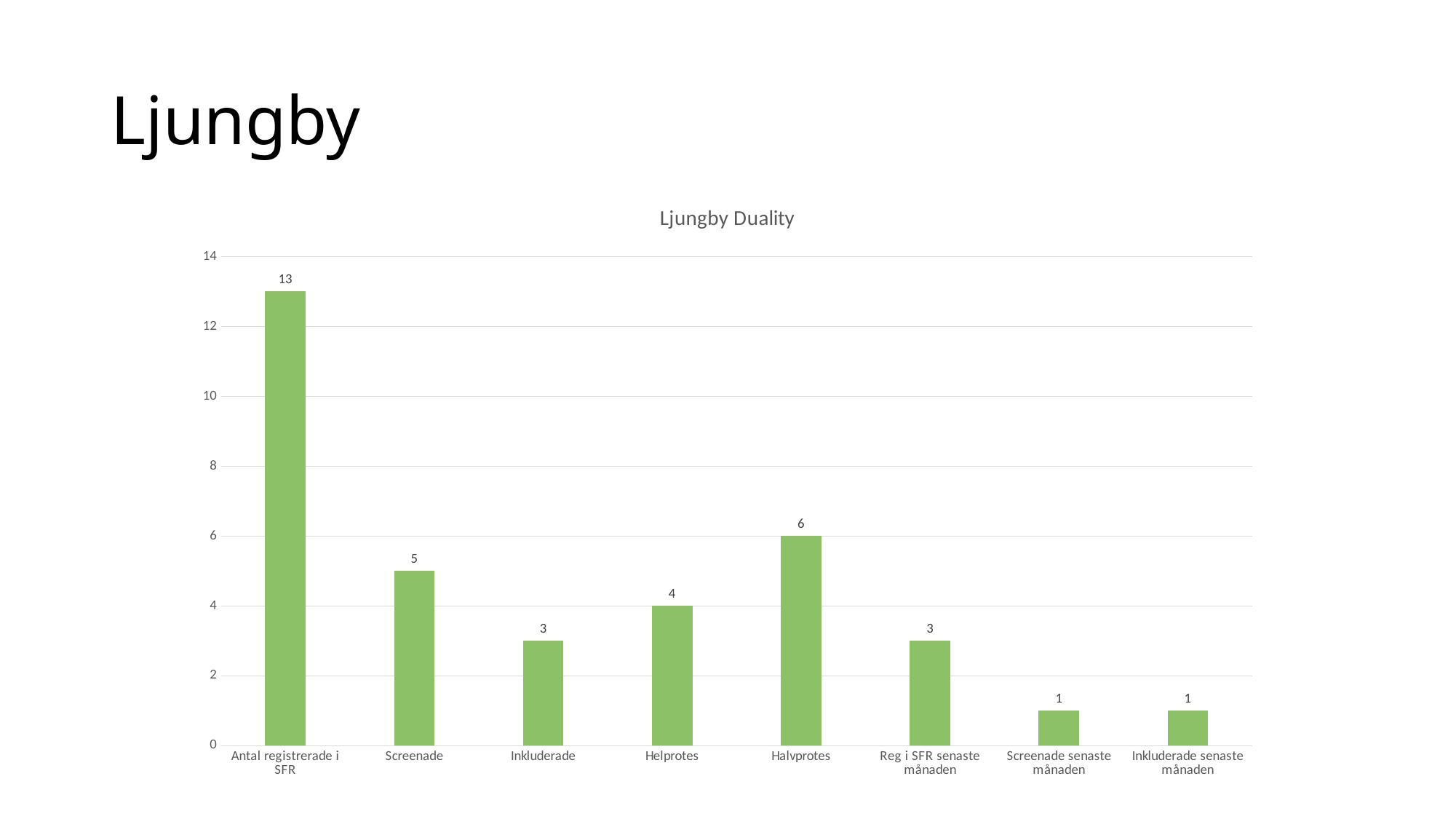
How many categories are shown on the x axis? 8 What is the value for Antal registrerade i SFR? 13 Which is larger, the value for Helprotes or the value for Halvprotes? Halvprotes What is the title of the chart? Ljungby Duality What is the value for Halvprotes? 6 Which category has the highest value? Antal registrerade i SFR What is the value for Screenade senaste månaden? 1 What is the difference between the values for Screenade and Inkluderade? 2 What is the value for Reg i SFR senaste månaden? 3 What kind of chart is shown? bar chart What is the difference between the values for Antal registrerade i SFR and Halvprotes? 7 Is the value for Antal registrerade i SFR greater or less than 10? greater